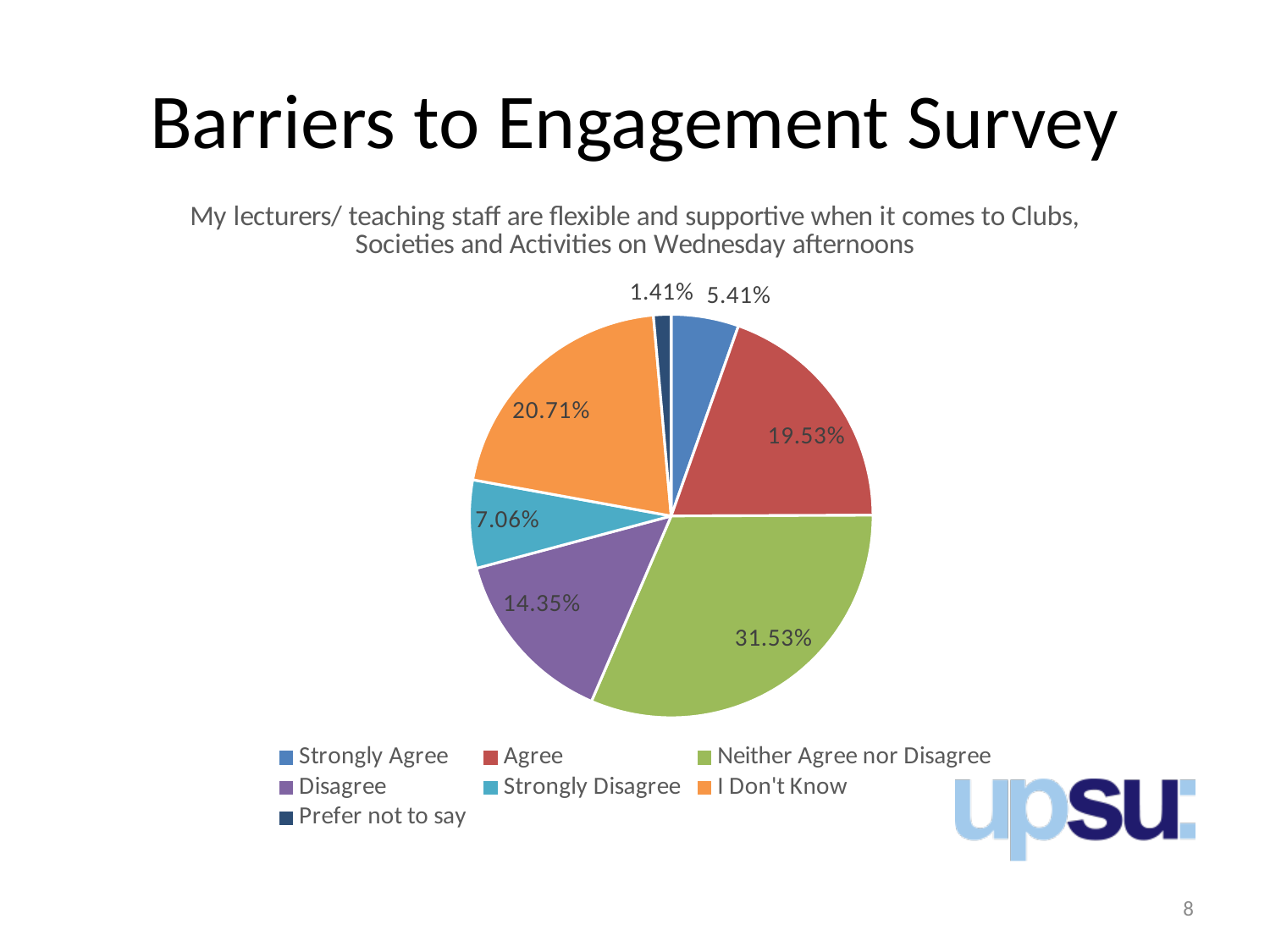
What type of chart is shown on the slide? pie chart What percentage of respondents answered 'Neither Agree nor Disagree'? 31.53% Which is larger, the share for 'I Don't Know' or the share for 'Agree'? I Don't Know What is the difference between the 'Agree' and 'Disagree' percentages? 5.18% How many response categories does the legend list? 7 What percentage of respondents answered 'Strongly Agree'? 5.41% What is the combined percentage of 'Strongly Agree' and 'Agree'? 24.94% Which response category has the smallest share of the pie? Prefer not to say What percentage of respondents answered 'I Don't Know'? 20.71% Which response category has the largest share of the pie? Neither Agree nor Disagree What survey statement is the pie chart about? My lecturers/ teaching staff are flexible and supportive when it comes to Clubs, Societies and Activities on Wednesday afternoons What percentage of respondents answered 'Strongly Disagree'? 7.06%